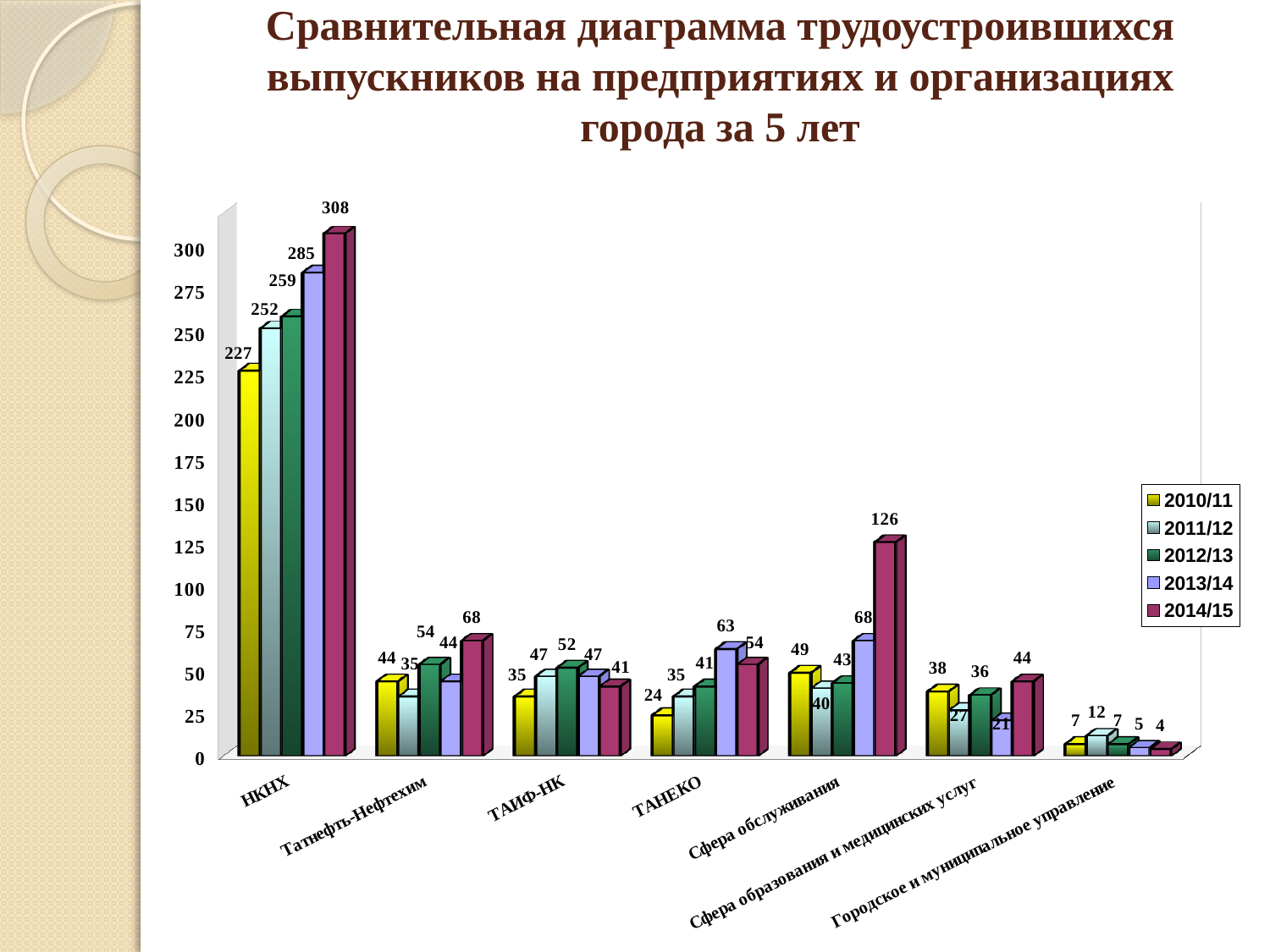
What is the value for Городское и муниципальное управление in 2011/12? 12 What is the difference between the 2014/15 and 2010/11 values for НКНХ? 81 How many series does the legend list? 5 How many categories are shown on the x axis? 7 What is the value for ТАНЕКО in 2013/14? 63 Which category has the lowest value in 2014/15? Городское и муниципальное управление What is the value for НКНХ in 2014/15? 308 Which category has the highest value in 2010/11? НКНХ What kind of chart is shown on the slide? Bar chart Which is larger for ТАИФ-НК: the 2012/13 value or the 2014/15 value? 2012/13 What is the value for Сфера обслуживания in 2014/15? 126 Do the values for НКНХ rise or fall from 2010/11 to 2014/15? Rise